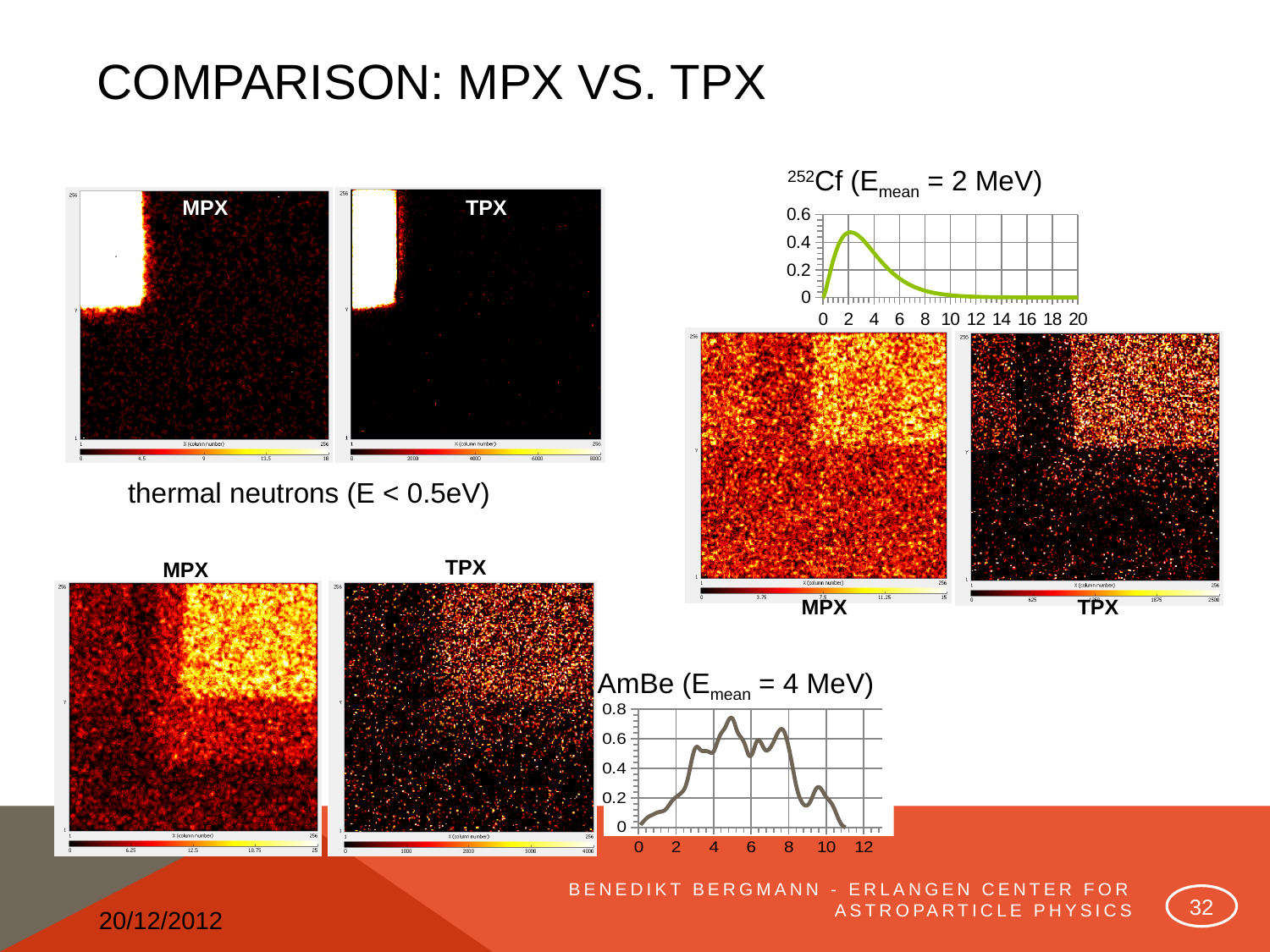
What is the highest value shown on the y axis of the "AmBe (Emean = 4 MeV)" chart? 0.8 What is the highest value shown on the x axis of the "252Cf (Emean = 2 MeV)" chart? 20 In the "AmBe (Emean = 4 MeV)" chart, does the curve rise or fall between x = 0 and x = 4? rise In the "AmBe (Emean = 4 MeV)" chart, is the value of the curve at x = 2 greater or less than 0.4? less What kind of chart is the "AmBe (Emean = 4 MeV)" chart? line chart In the "252Cf (Emean = 2 MeV)" chart, is the peak value of the curve greater or less than 0.4? greater In the "AmBe (Emean = 4 MeV)" chart, is the highest value of the curve greater or less than 0.6? greater What kind of chart is the "252Cf (Emean = 2 MeV)" chart? line chart In the "252Cf (Emean = 2 MeV)" chart, does the curve rise or fall between x = 4 and x = 12? fall